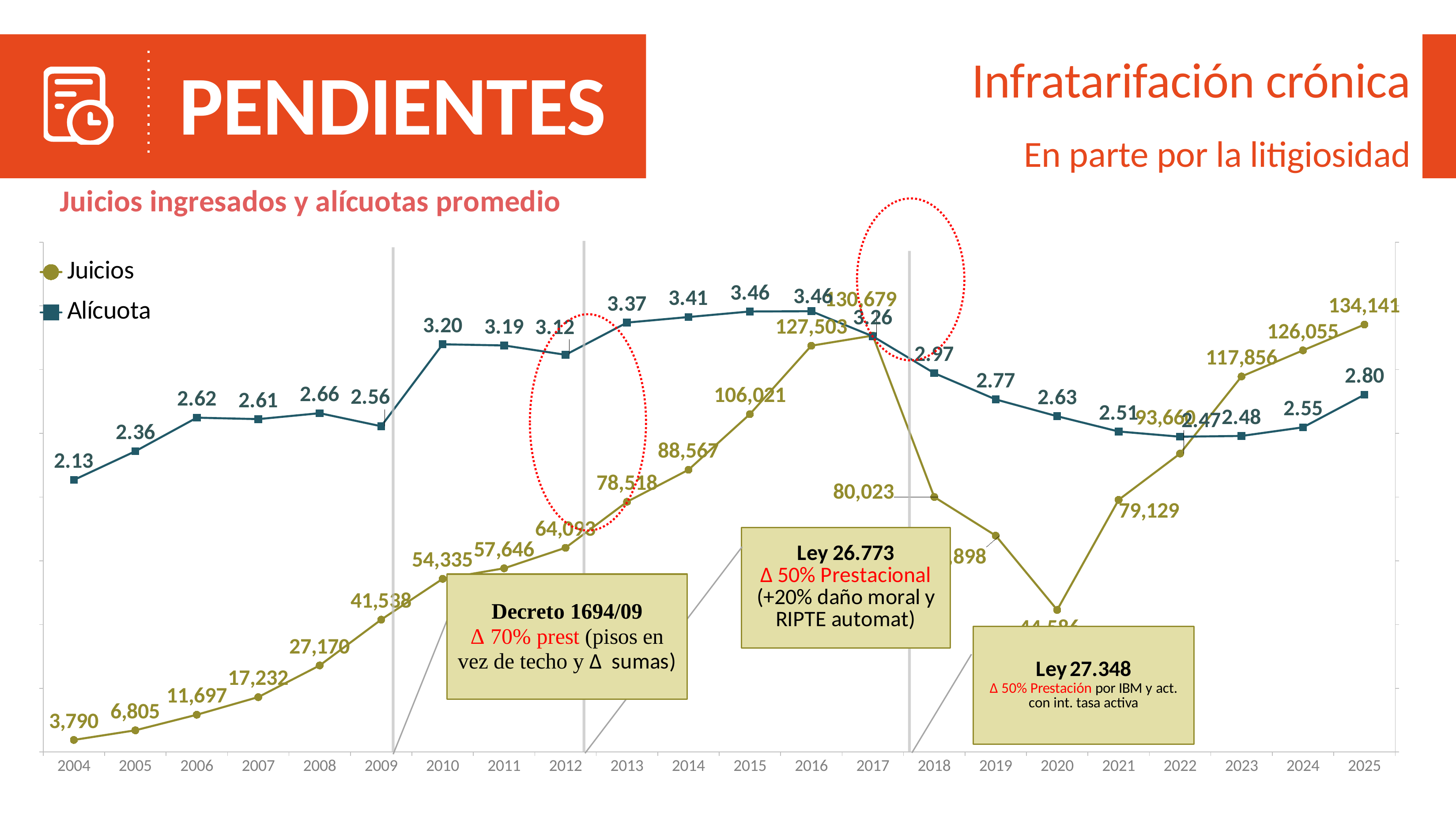
How many years are plotted along the x axis of the chart? 22 What is the difference between the Juicios values for 2017 and 2016? 3,176 Does the Alícuota series rise or fall from 2016 to 2022? fall Which is larger, the Juicios value for 2023 or for 2018? 2023 How many series does the chart legend list? 2 By how much did the Alícuota change from 2009 to 2010? 0.64 What type of chart is shown on the slide? line chart What is the Juicios value for 2017? 130,679 In which year is the Juicios series at its highest? 2025 What is the Juicios value for 2009? 41,538 In which year is the Alícuota series at its lowest? 2004 What is the Alícuota value for 2010? 3.20